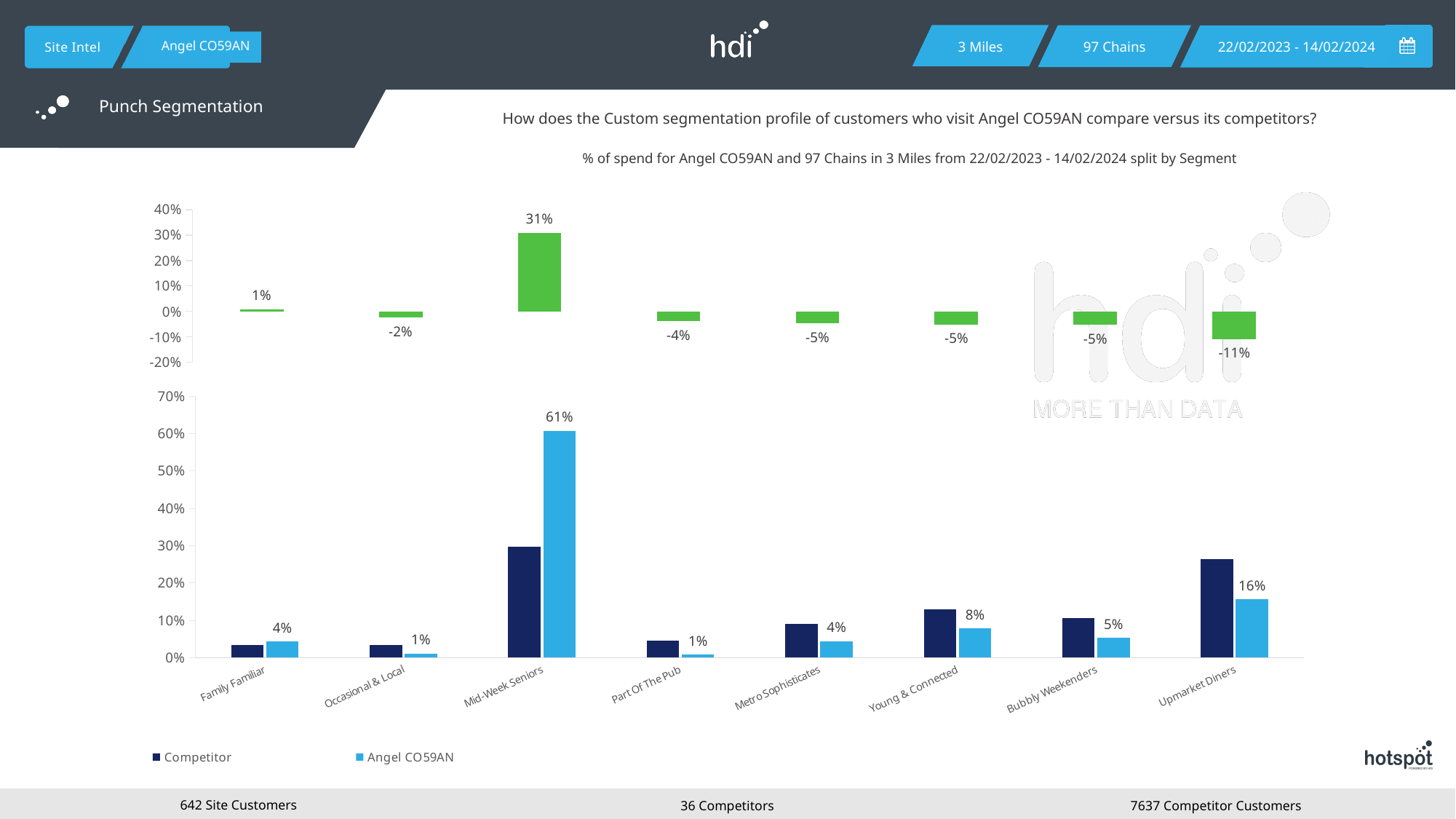
How many segments are shown on the x axis of the bottom chart? 8 In the bottom chart, which segment has the highest Angel CO59AN value? Mid-Week Seniors In the bottom chart, is the Competitor value for Mid-Week Seniors greater or less than 40%? less In the top chart, which segment has the lowest value? Upmarket Diners In the top chart, what is the value shown for Upmarket Diners? -11% In the bottom chart, what is the Angel CO59AN value for Mid-Week Seniors? 61% In the top chart, which segment has the highest value? Mid-Week Seniors In the bottom chart, what is the Angel CO59AN value for Upmarket Diners? 16% In the bottom chart, is the Competitor value for Upmarket Diners greater or less than 20%? greater How many series does the legend of the bottom chart list? 2 In the bottom chart, for Young & Connected, which series has the larger value: Competitor or Angel CO59AN? Competitor In the bottom chart, what is the difference between the Angel CO59AN values for Mid-Week Seniors and Upmarket Diners? 45 percentage points